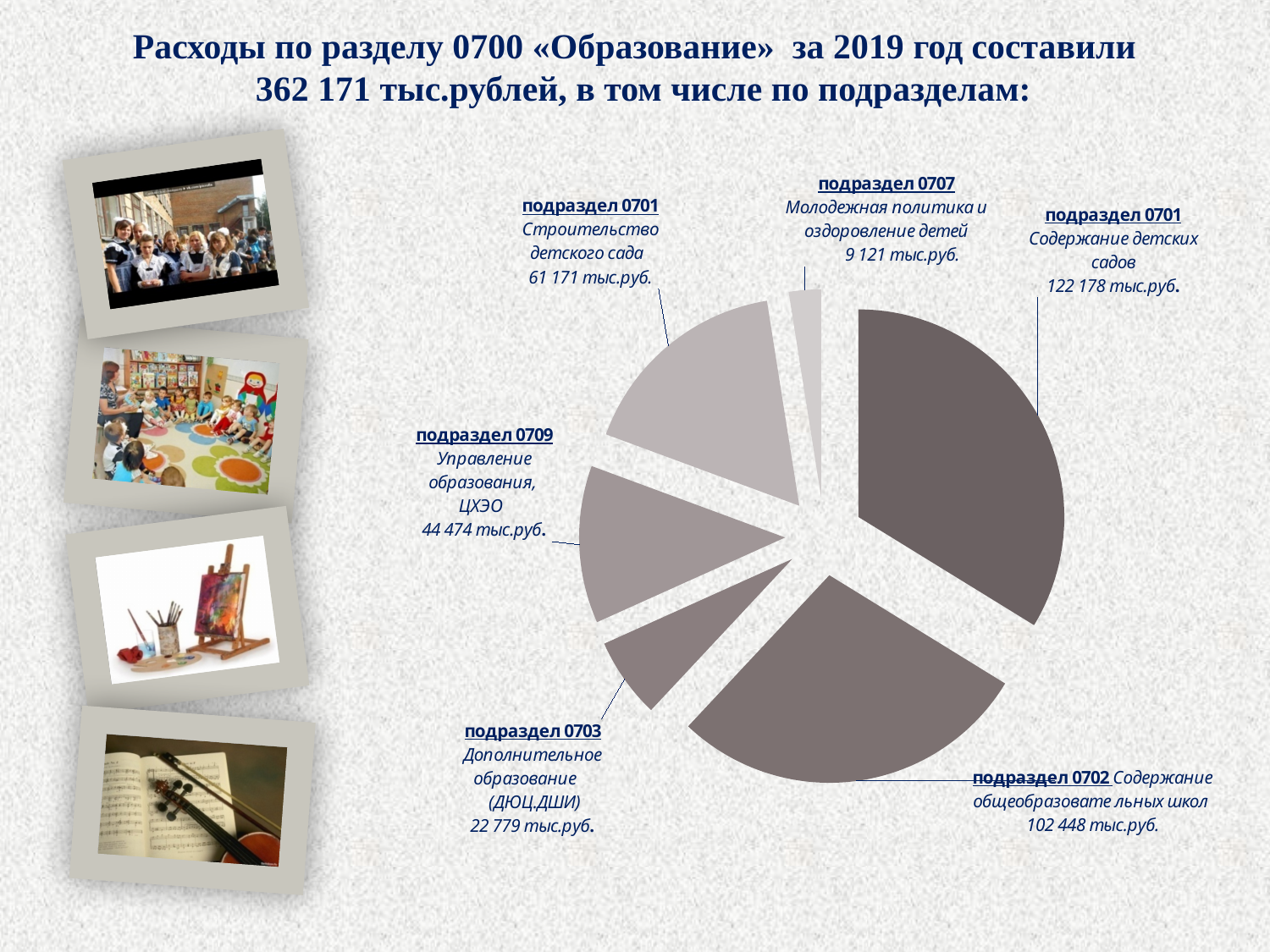
What is the total of all the slices in the pie chart? 362 171 тыс.руб. What is the value for подраздел 0709 Управление образования, ЦХЭО? 44 474 тыс.руб. What is the value for подраздел 0702 Содержание общеобразовательных школ? 102 448 тыс.руб. What kind of chart is shown on the slide? pie chart Which is larger: the value for подраздел 0701 Строительство детского сада or the value for подраздел 0709 Управление образования, ЦХЭО? подраздел 0701 Строительство детского сада How many slices does the pie chart have? 6 Which subsection has the smallest share of the pie? подраздел 0707 Молодежная политика и оздоровление детей What is the value for подраздел 0707 Молодежная политика и оздоровление детей? 9 121 тыс.руб. Which subsection has the largest share of the pie? подраздел 0701 Содержание детских садов What is the difference between the value for Содержание детских садов and the value for Содержание общеобразовательных школ? 19 730 тыс.руб. What is the value for подраздел 0701 Содержание детских садов? 122 178 тыс.руб. What total expenditure for section 0700 «Образование» in 2019 is stated in the slide title? 362 171 тыс.рублей